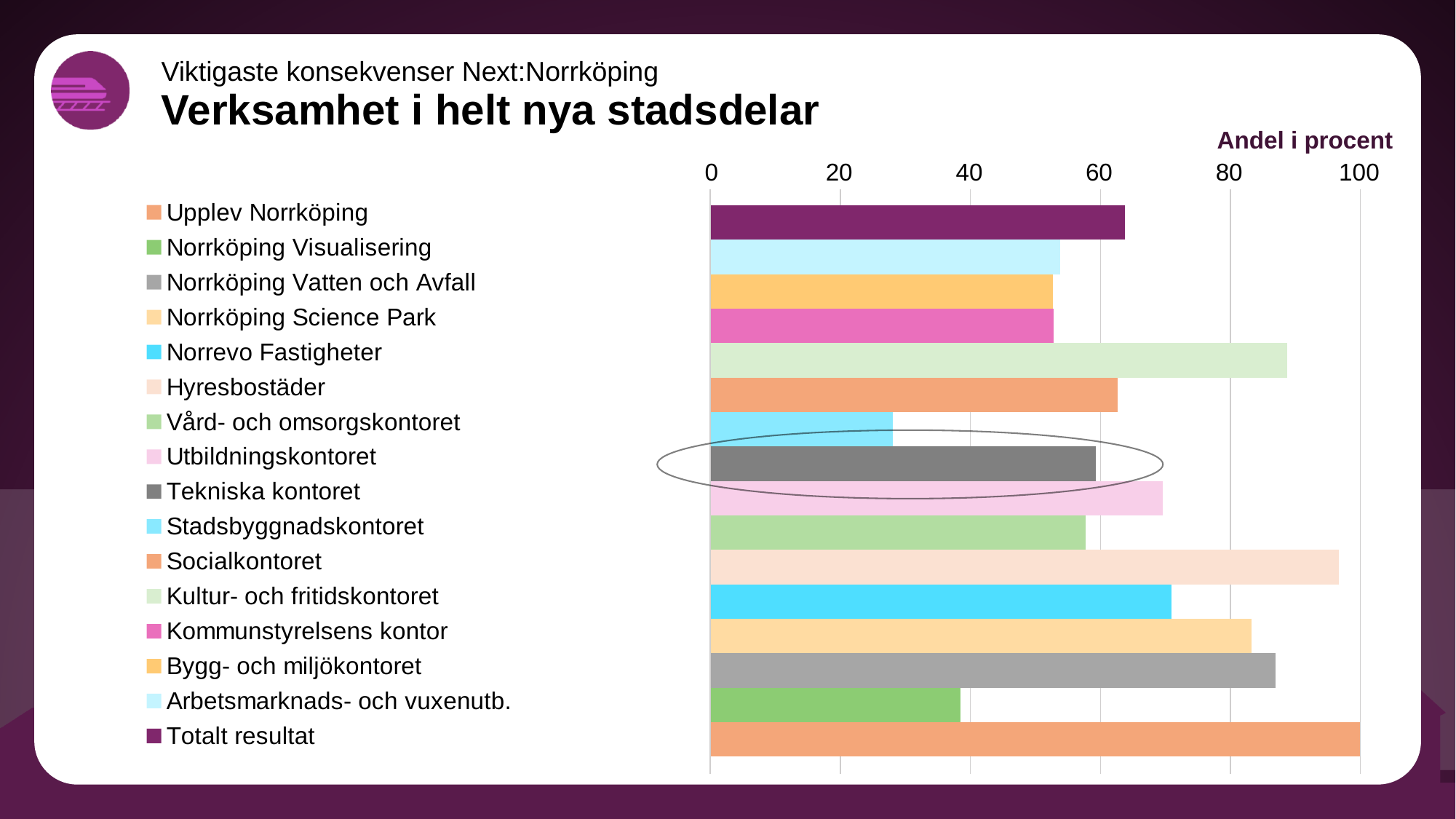
Which bar is circled on the chart? Tekniska kontoret What kind of chart is shown on the slide? bar chart Is the value for Norrköping Visualisering greater or less than 40? less What is the axis title shown above the chart? Andel i procent Which category has the lowest value? Stadsbyggnadskontoret How many categories does the legend list? 16 Is the value for Stadsbyggnadskontoret greater or less than 40? less Which category has the highest value? Upplev Norrköping Is the value for Hyresbostäder greater or less than 80? greater Which is larger, the value for Norrköping Vatten och Avfall or the value for Vård- och omsorgskontoret? Norrköping Vatten och Avfall What is the value for Upplev Norrköping? 100